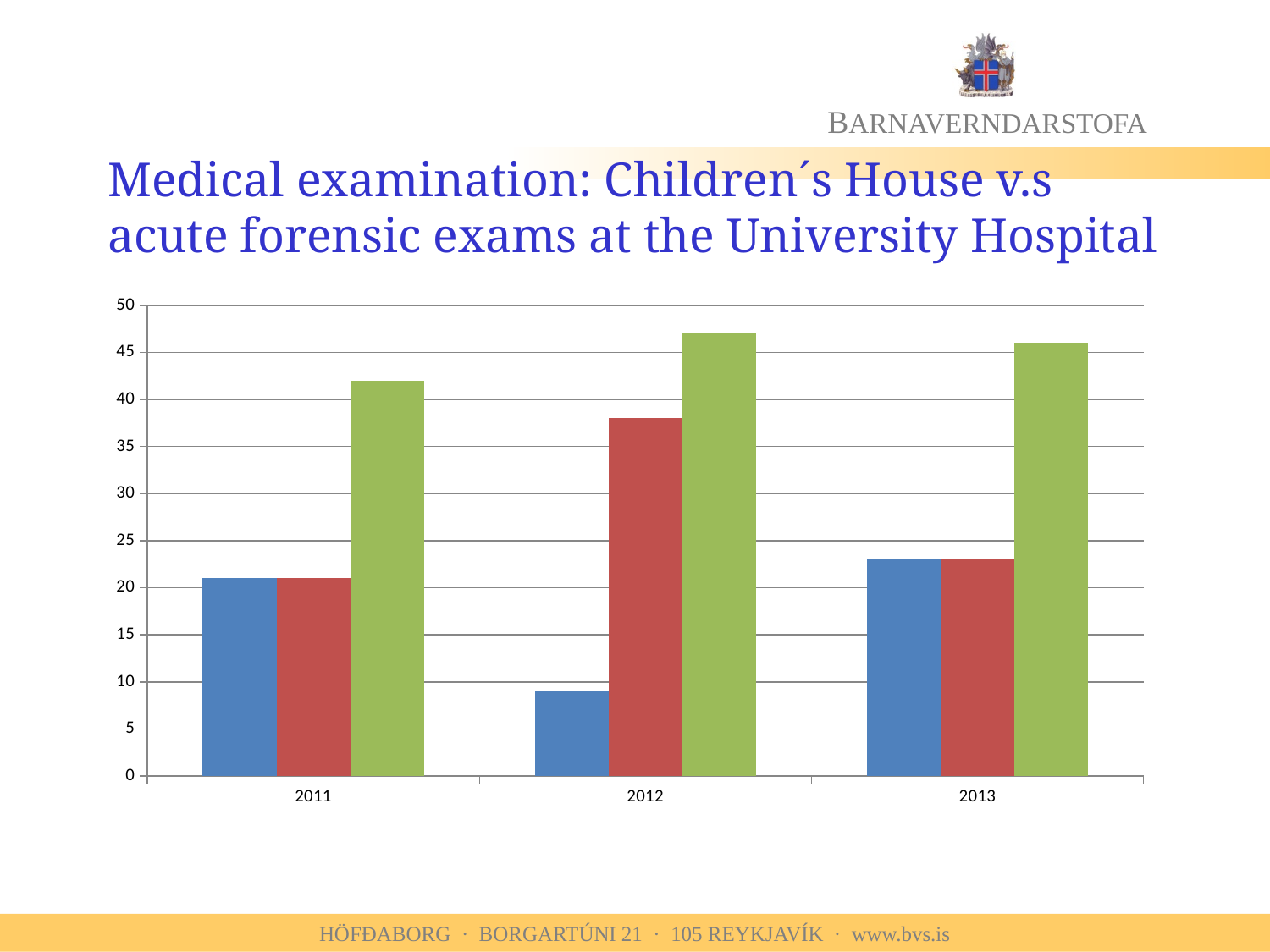
How many years are shown on the x axis of the chart? 3 Is the value of the blue bar for 2012 greater or less than 15? less In which year is the green bar the shortest? 2011 In which year is the blue bar the shortest? 2012 Is the value of the red bar for 2012 greater or less than 35? greater What kind of chart is shown on the slide? bar chart What is the title of the chart on the slide? Medical examination: Children´s House v.s acute forensic exams at the University Hospital Which colour bar is the tallest in every year shown? green Is the value of the green bar for 2011 greater or less than 40? greater How many bars are plotted for each year in the chart? 3 In 2012, is the red bar or the blue bar taller? red In which year is the red bar the tallest? 2012